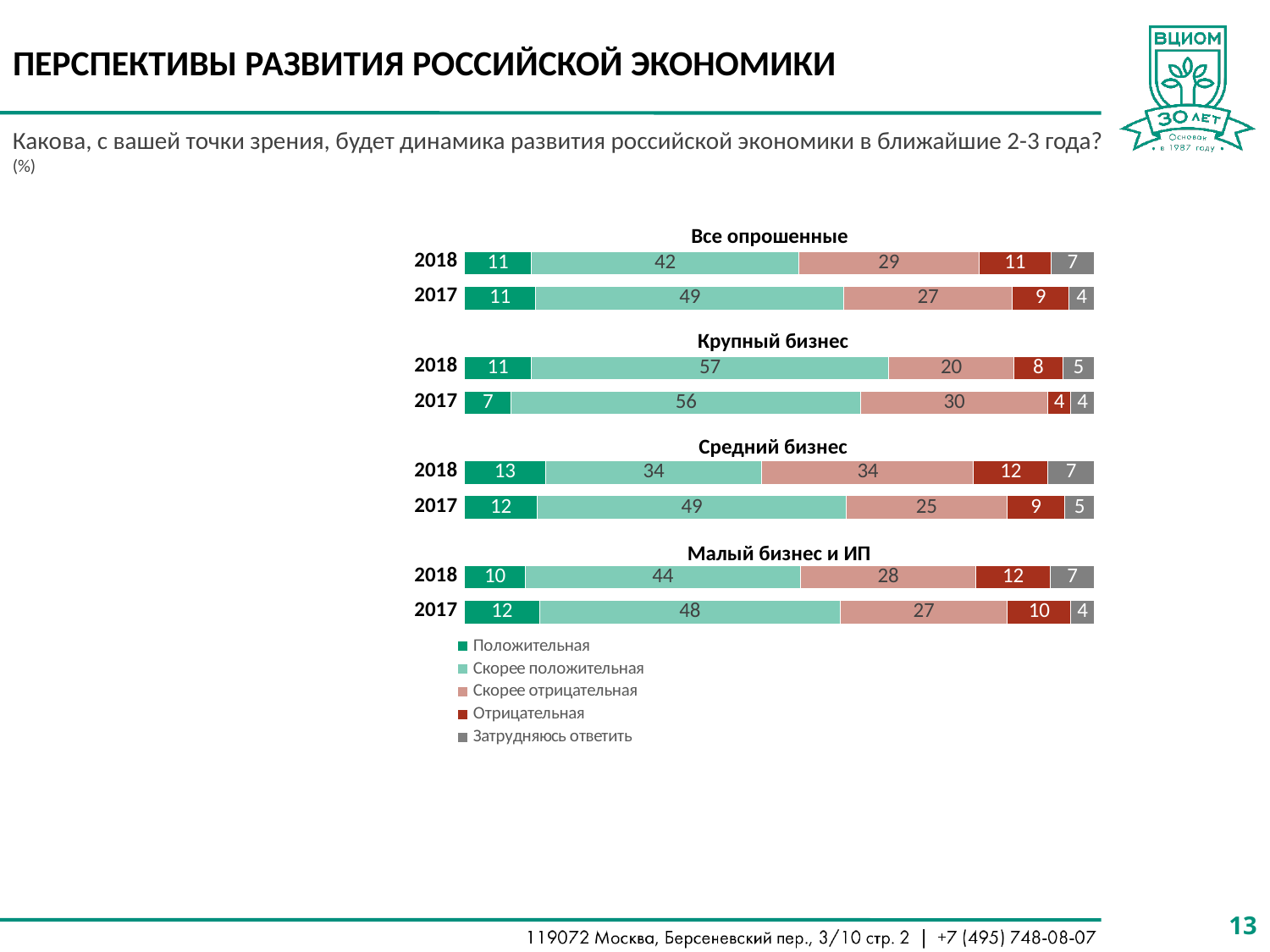
In the 'Все опрошенные' chart, what is the difference between the 'Скорее положительная' values for 2017 and 2018? 7 In the 'Малый бизнес и ИП' chart, which segment is the smallest in the 2017 bar? Затрудняюсь ответить In the 'Крупный бизнес' chart, what is the value of 'Скорее отрицательная' for 2017? 30 In the 'Средний бизнес' chart, which segment is the largest in the 2017 bar? Скорее положительная How many bars (years) does the 'Крупный бизнес' chart show? 2 How many series does the legend list? 5 What kind of chart is used on this slide? Stacked bar chart In the 'Все опрошенные' chart, what is the total of the 2018 stacked bar? 100 In the 'Средний бизнес' chart, what is the value of 'Положительная' for 2018? 13 In the 'Крупный бизнес' chart, which year has the larger 'Положительная' value, 2018 or 2017? 2018 In the 'Малый бизнес и ИП' chart, what is the value of 'Отрицательная' for 2017? 10 In the 'Все опрошенные' chart, what is the value of 'Скорее положительная' for 2018? 42